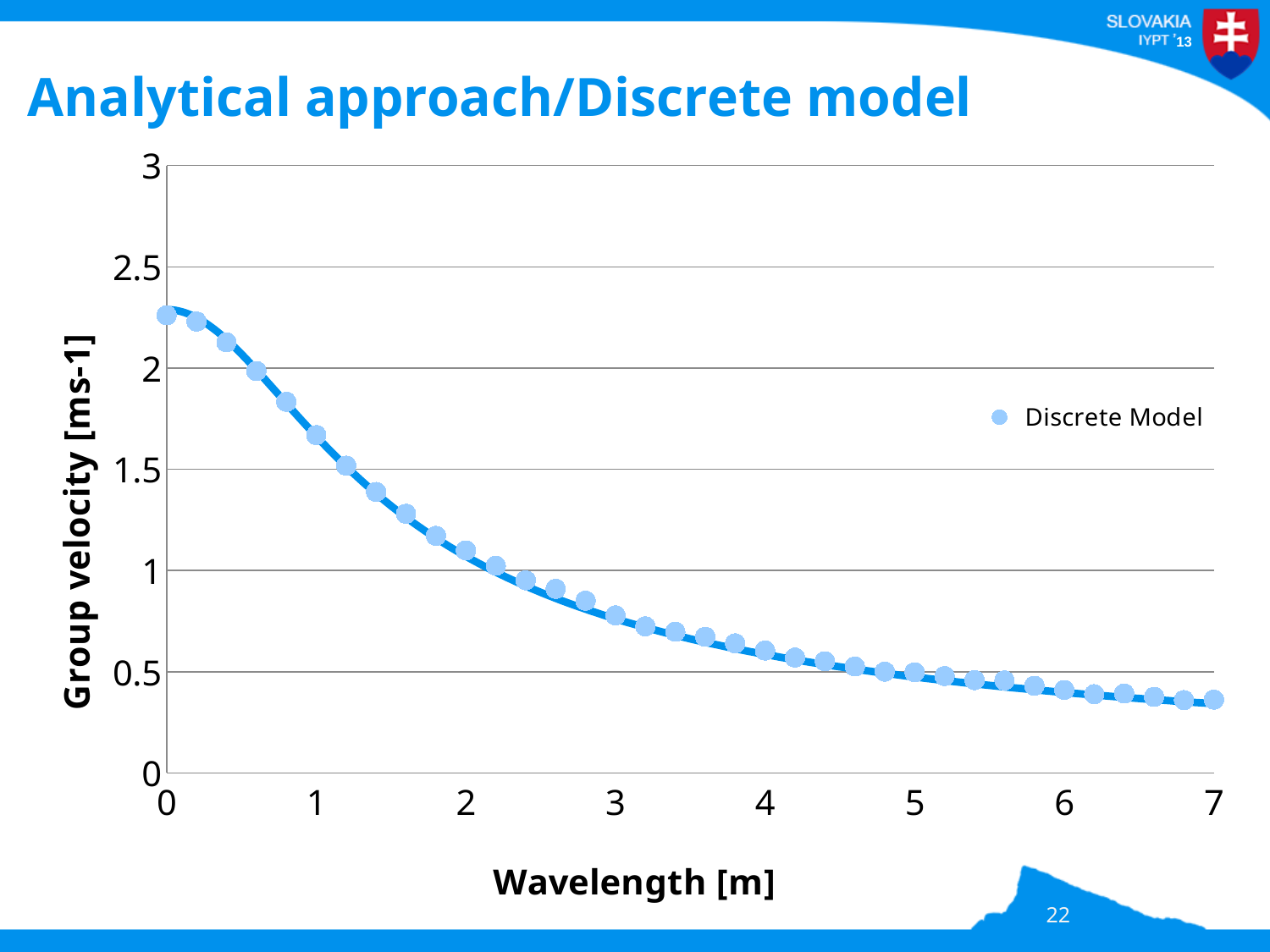
What kind of chart is shown on the slide? Scatter chart with a smooth line What is the title of the vertical axis? Group velocity [ms-1] Does the group velocity rise or fall as wavelength increases along the x axis? Fall Which has the larger group velocity: wavelength 1 or wavelength 3? Wavelength 1 Is the group velocity at wavelength 1 greater or less than 1.5? greater What is the name of the series shown in the legend? Discrete Model Is the group velocity at wavelength 0 greater or less than 2? greater Is the group velocity at wavelength 7 greater or less than 0.5? less How many series does the legend list? 1 At which wavelength is the group velocity highest? 0